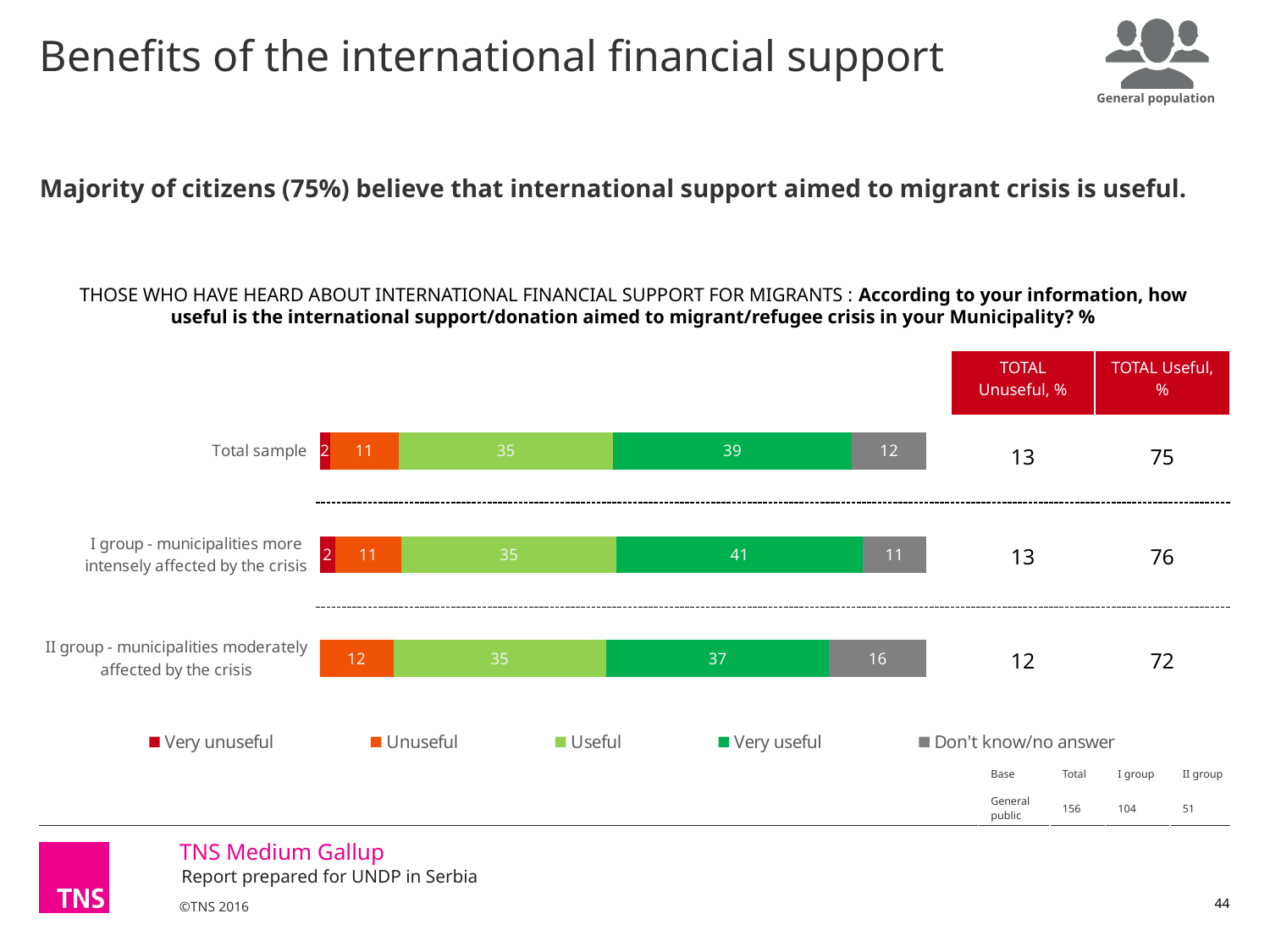
Which category has the lowest 'Very useful' value? II group - municipalities moderately affected by the crisis Which category has the highest 'Very useful' value? I group - municipalities more intensely affected by the crisis What is the TOTAL Useful, % value for the Total sample? 75 How many categories (rows) are plotted in the chart? 3 What is the 'Don't know/no answer' value for II group - municipalities moderately affected by the crisis? 16 Is the 'Don't know/no answer' value larger for the Total sample or for I group? Total sample Which colour represents the 'Useful' series in the legend? light green What kind of chart is shown on the slide? stacked bar chart What is the difference between the 'Very useful' values for I group and II group? 4 What is the 'Very useful' value for the Total sample? 39 How many series does the legend list? 5 What is the 'Unuseful' value for I group - municipalities more intensely affected by the crisis? 11